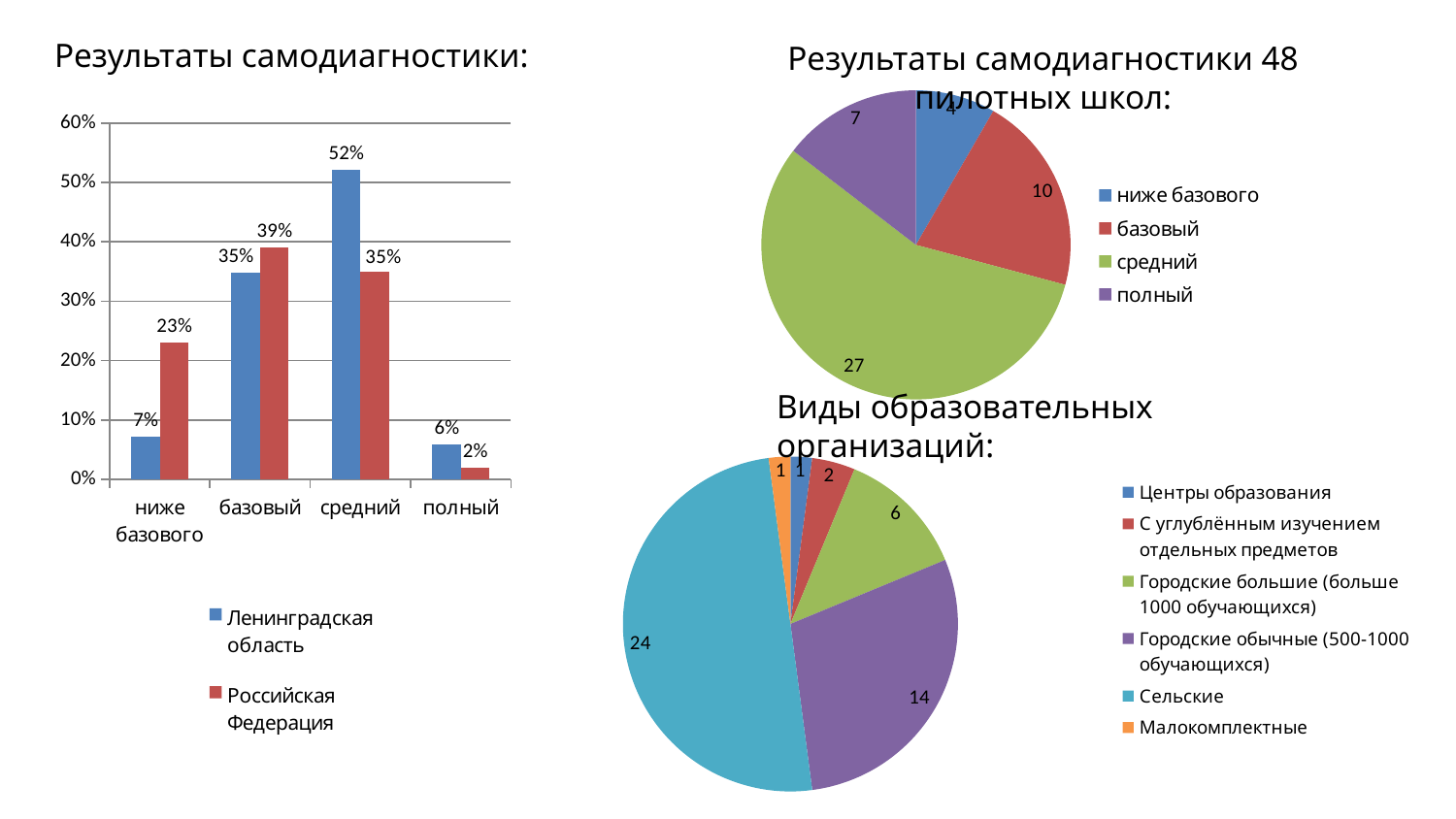
What kind of chart is 'Результаты самодиагностики' on the left of the slide? bar chart In the pie chart 'Результаты самодиагностики 48 пилотных школ', what is the value for 'средний'? 27 In the bar chart 'Результаты самодиагностики', what is the difference between the 'базовый' values for Российская Федерация and Ленинградская область? 4% In the pie chart 'Виды образовательных организаций', what is the value for 'Городские обычные (500-1000 обучающихся)'? 14 In the bar chart 'Результаты самодиагностики', how many series does the legend list? 2 In the pie chart 'Виды образовательных организаций', which category has the largest slice? Сельские In the bar chart 'Результаты самодиагностики', which category has the lowest value for Российская Федерация? полный In the bar chart 'Результаты самодиагностики', what is the value for 'средний' for Ленинградская область? 52% In the bar chart 'Результаты самодиагностики', what is the value for 'ниже базового' for Российская Федерация? 23% In the pie chart 'Результаты самодиагностики 48 пилотных школ', which category has the smallest slice? ниже базового How many categories does the legend of the pie chart 'Виды образовательных организаций' list? 6 In the bar chart 'Результаты самодиагностики', which is larger for 'средний': Ленинградская область or Российская Федерация? Ленинградская область